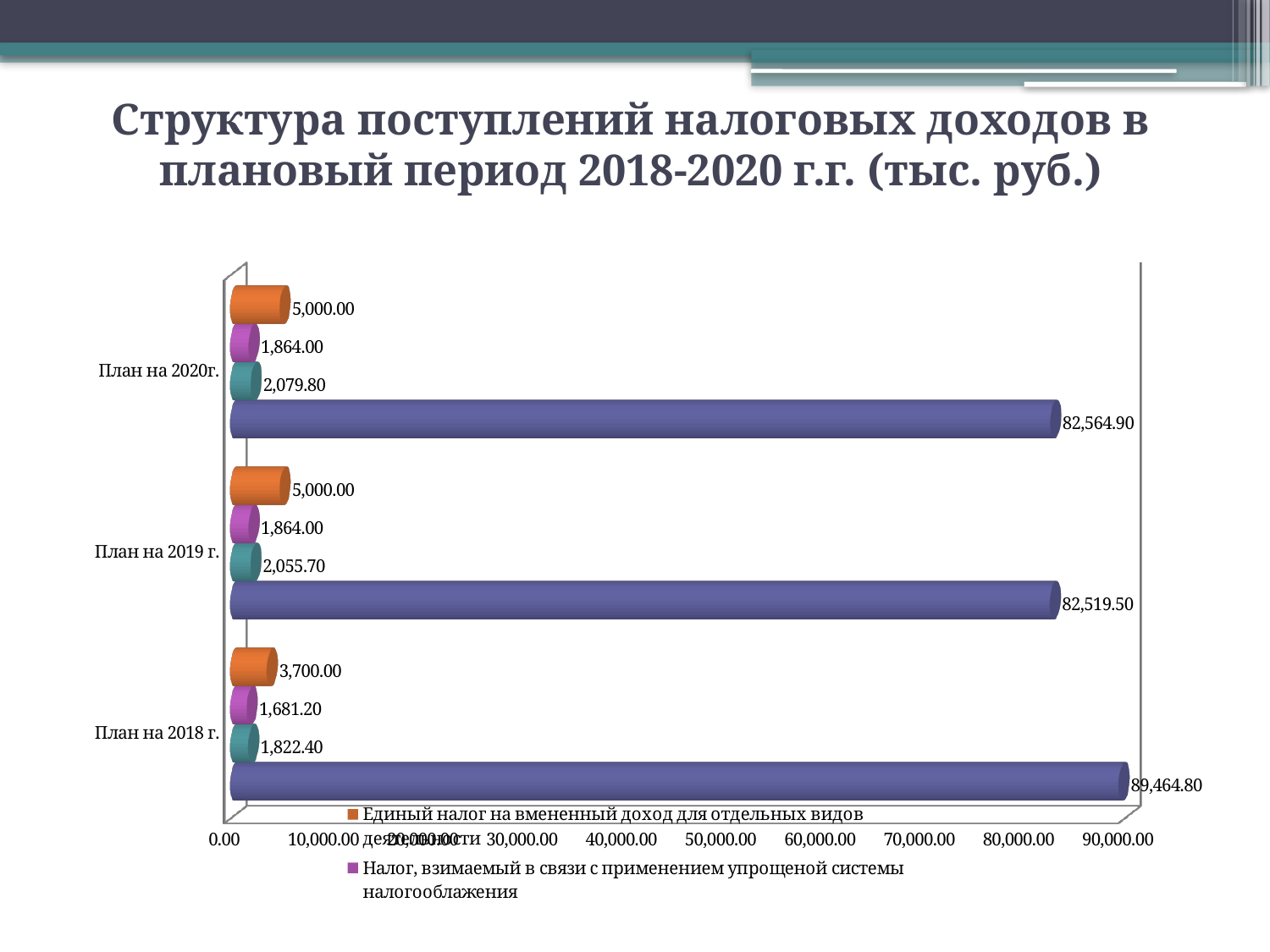
Is the value of 'Налог, взимаемый в связи с применением упрощеной системы налогообложения' for План на 2019 г. greater or less than 80,000.00? less What is the title of the slide? Структура поступлений налоговых доходов в плановый период 2018-2020 г.г. (тыс. руб.) What is the difference between the 'Единый налог на вмененный доход для отдельных видов деятельности' values for План на 2020г. and План на 2018 г.? 1,300.00 What is the value of 'Единый налог на вмененный доход для отдельных видов деятельности' for План на 2020г.? 5,000.00 How many plan years (categories) are shown on the chart? 3 Which is larger for 'Налог, взимаемый в связи с применением упрощеной системы налогообложения': План на 2018 г. or План на 2020г.? План на 2020г. What is the difference between the 'Налог, взимаемый в связи с применением упрощеной системы налогообложения' values for План на 2020г. and План на 2019 г.? 0.00 What kind of chart is shown on the slide? bar chart What is the value of 'Налог, взимаемый в связи с применением упрощеной системы налогообложения' for План на 2018 г.? 1,681.20 Which plan year has the lowest value for 'Единый налог на вмененный доход для отдельных видов деятельности'? План на 2018 г. What is the value of 'Налог, взимаемый в связи с применением упрощеной системы налогообложения' for План на 2019 г.? 1,864.00